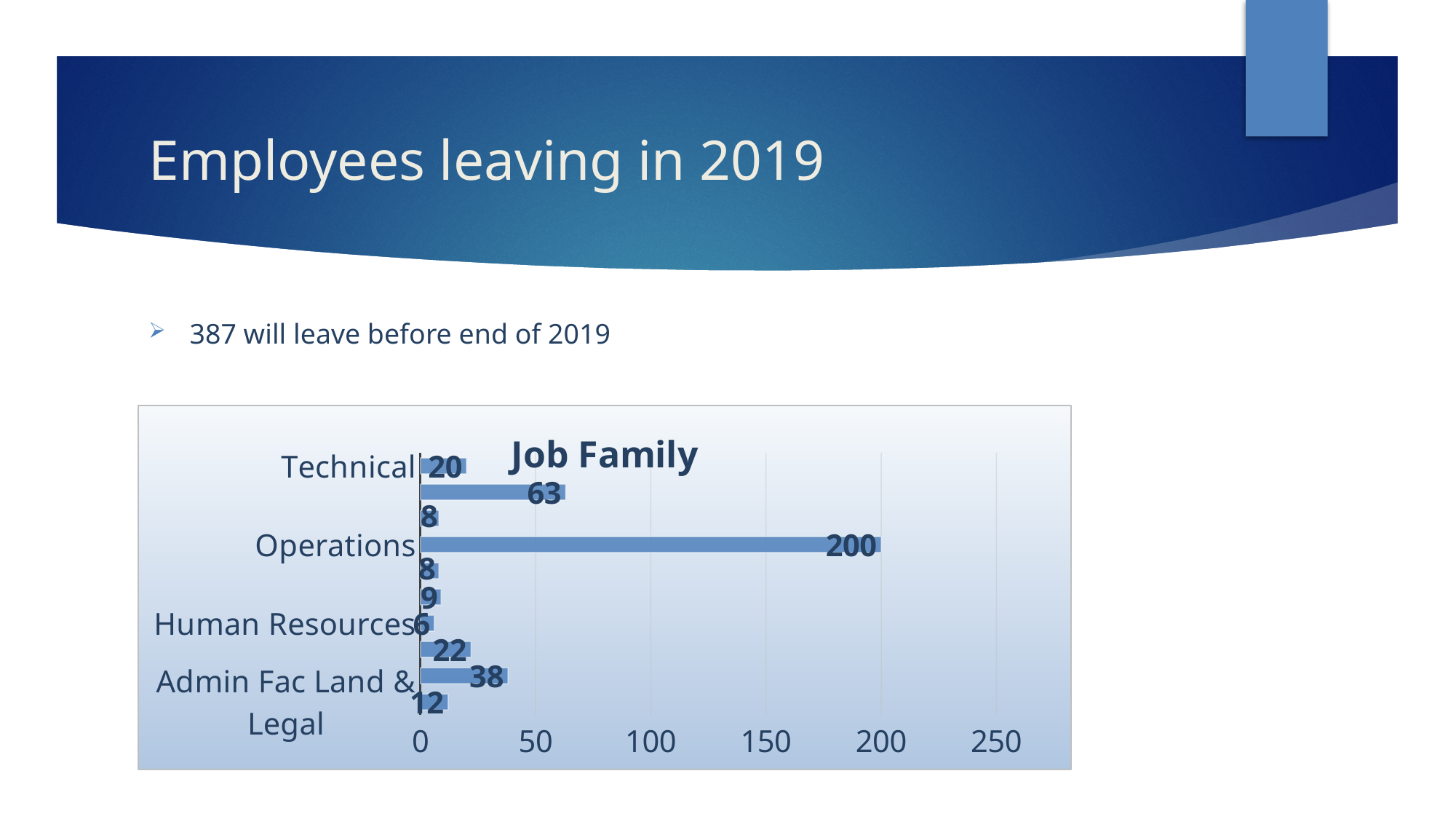
How many bars are plotted in the Job Family chart? 10 Is the value for Operations greater or less than 150? greater Which is larger, the value for Operations or the value for Technical? Operations What is the value for Operations in the Job Family chart? 200 What type of chart is shown on the slide? bar chart What is the smallest data label shown in the Job Family chart? 6 What is the value for Technical in the Job Family chart? 20 What is the title of the chart? Job Family What is the difference between the values for Operations and Technical? 180 What is the value for Human Resources in the Job Family chart? 6 Which category has the highest value in the Job Family chart? Operations What is the largest data label shown in the Job Family chart? 200